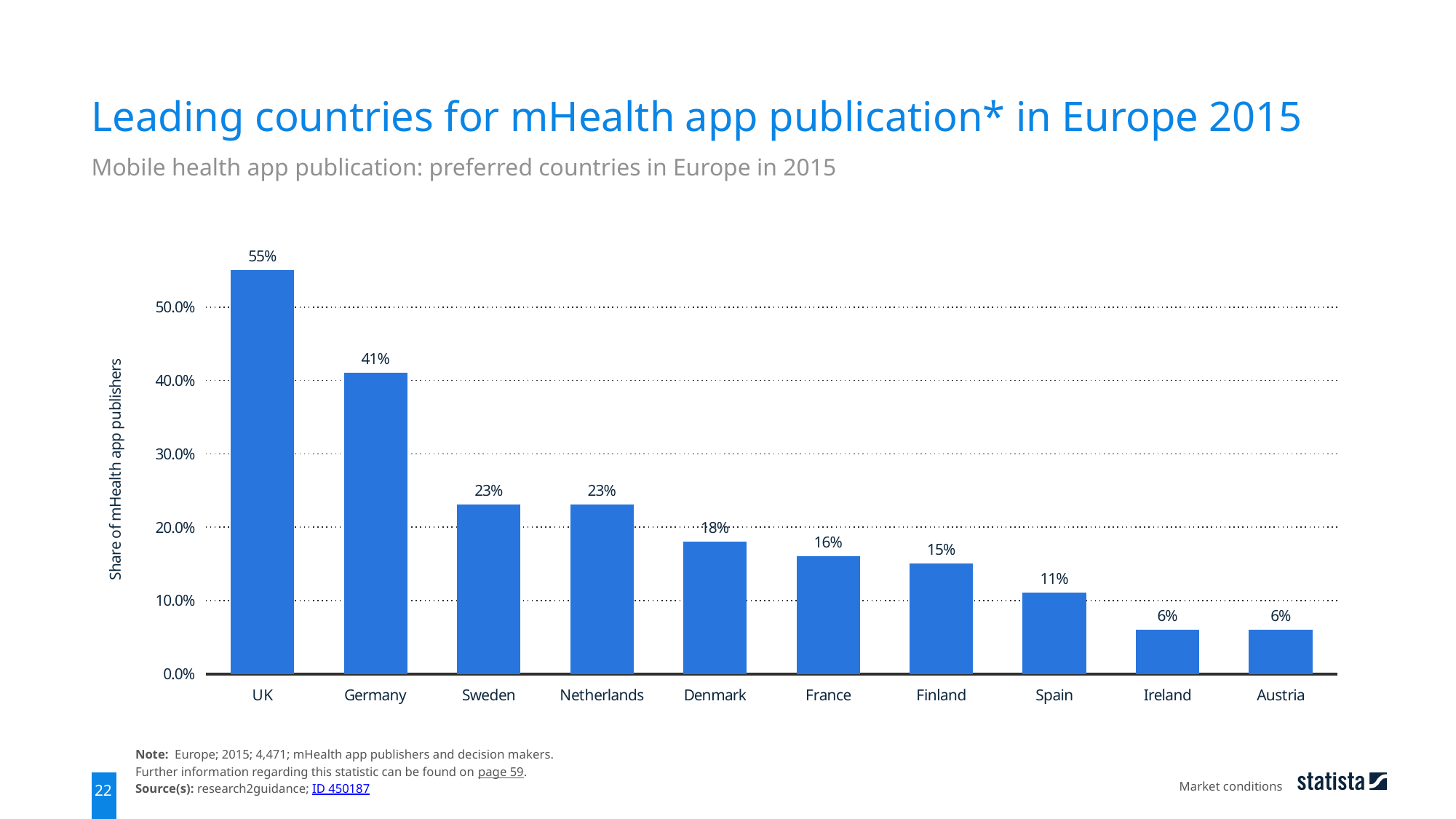
Is the value for Germany greater or less than 40.0%? greater Do the values rise or fall from left to right across the countries? Fall What is the label of the vertical axis? Share of mHealth app publishers Which has a larger share of mHealth app publishers, Finland or Spain? Finland What kind of chart is shown on the slide? Bar chart What is the share of mHealth app publishers for Denmark? 18% Which country has the highest share of mHealth app publishers? UK What is the share of mHealth app publishers for Spain? 11% What is the difference between the shares for the UK and Germany? 14% What is the share of mHealth app publishers for Germany? 41% How many countries are shown in the chart? 10 What is the difference between the shares for Sweden and France? 7%